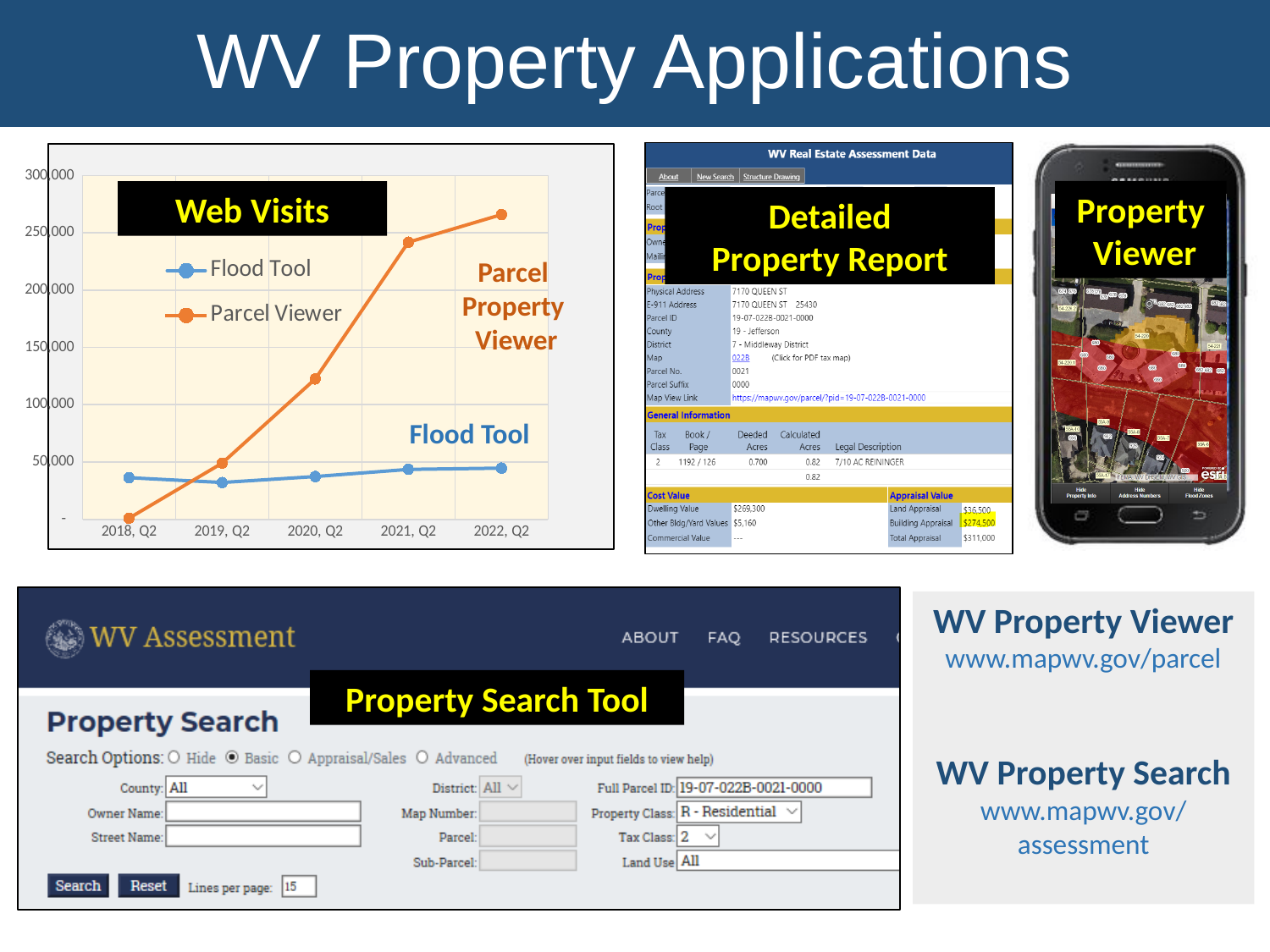
How many time points are shown on the x axis of the Web Visits chart? 5 In the Web Visits chart, is the Flood Tool value for 2022, Q2 greater or less than 100,000? less In the Web Visits chart, which series has the larger value at 2022, Q2, Flood Tool or Parcel Viewer? Parcel Viewer What is the title of the line chart on the slide? Web Visits What kind of chart is the Web Visits chart? line chart In the Web Visits chart, which series has the larger value at 2018, Q2, Flood Tool or Parcel Viewer? Flood Tool How many series does the legend of the Web Visits chart list? 2 In the Web Visits chart, do the Parcel Viewer values rise or fall from 2018, Q2 to 2022, Q2? rise In the Web Visits chart, is the Parcel Viewer value for 2021, Q2 greater or less than 200,000? greater In the Web Visits chart, at which time point is the Parcel Viewer value lowest? 2018, Q2 In the Web Visits chart, is the Parcel Viewer value for 2020, Q2 greater or less than 100,000? greater In the Web Visits chart, at which time point is the Parcel Viewer value highest? 2022, Q2